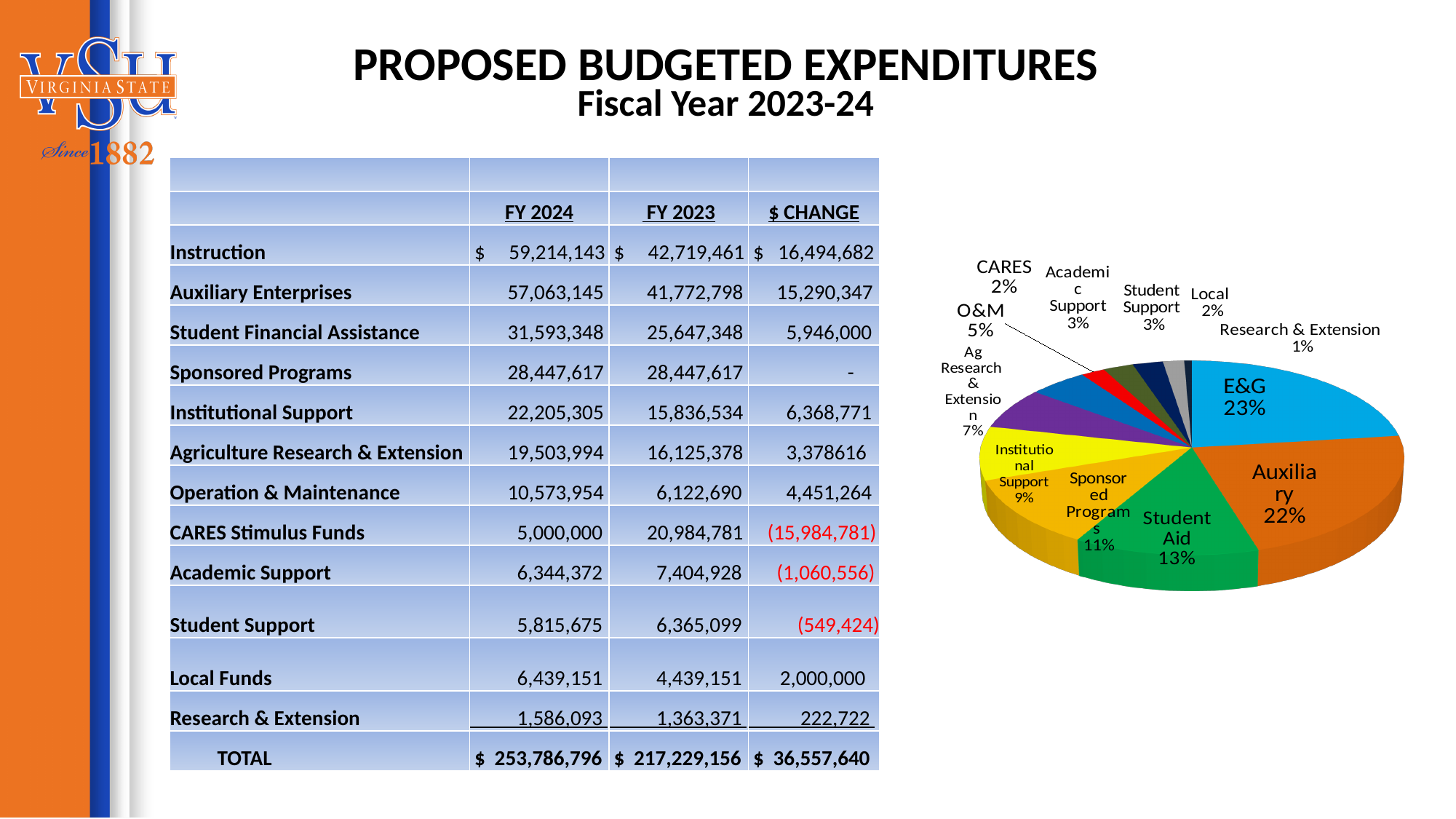
What percentage is shown for O&M in the pie chart? 5% What type of chart is shown on the slide? pie chart What is the difference in percentage points between Student Aid and Ag Research & Extension in the pie chart? 6 Which slice of the pie chart is the largest? E&G Which slice of the pie chart is the smallest? Research & Extension What share of the pie does E&G represent? 23% Which is larger in the pie chart, Sponsored Programs or Institutional Support? Sponsored Programs What percentage is shown for Student Aid in the pie chart? 13% What share of the pie does Auxiliary represent? 22% How many slices does the pie chart have? 12 What percentage is shown for Sponsored Programs in the pie chart? 11% What percentage is shown for Institutional Support in the pie chart? 9%